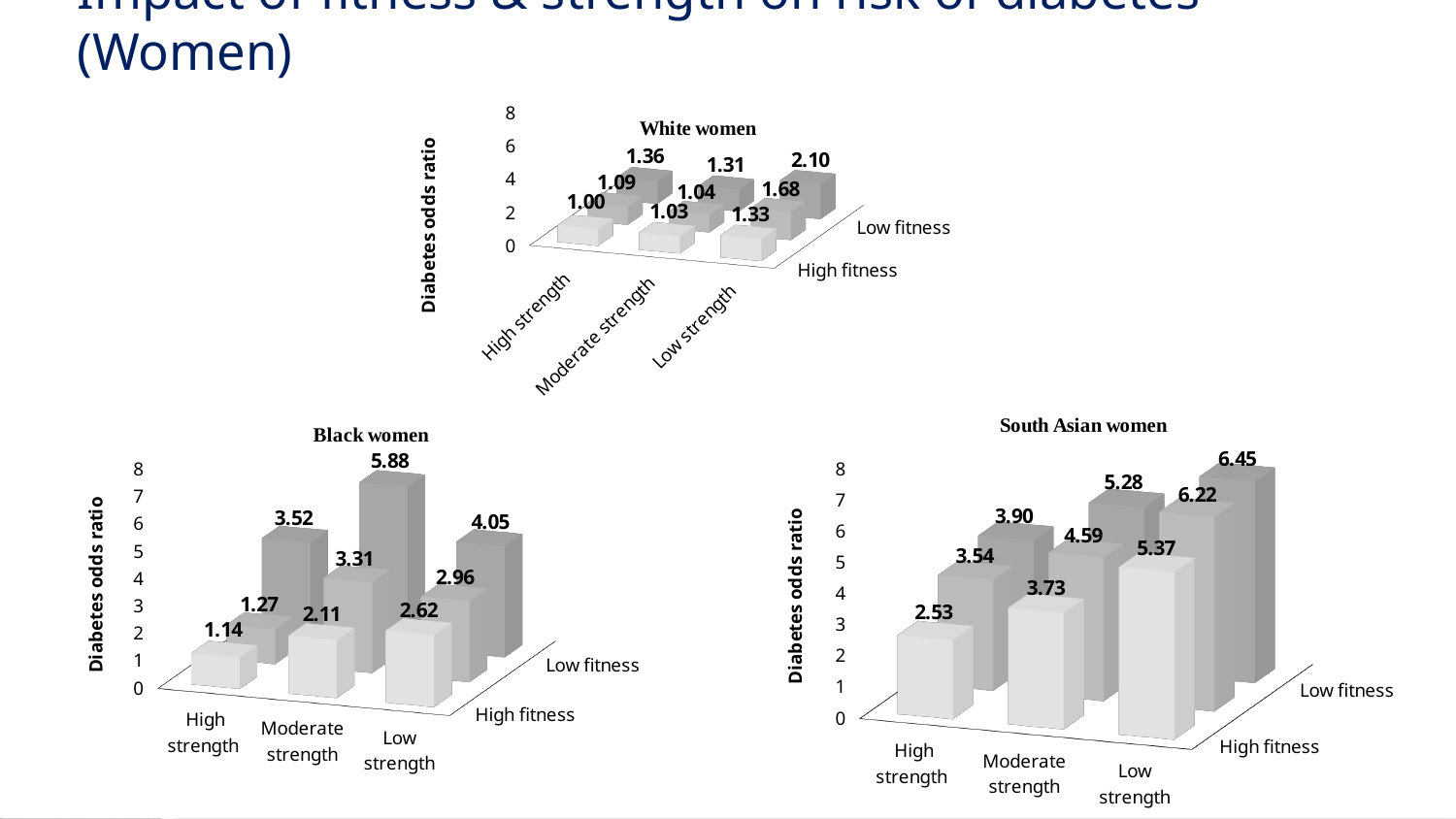
In the Black women chart, do the high fitness odds ratios rise or fall going from high strength to low strength? Rise In the White women chart, what is the diabetes odds ratio for low strength with high fitness? 1.33 In the White women chart, for low fitness, what is the difference between the odds ratio for low strength and for high strength? 0.74 What kind of chart is used for the Black women data? Bar chart How many strength categories are shown along the x axis of the Black women chart? 3 In the Black women chart, for low fitness, what is the difference between the odds ratio for moderate strength and for high strength? 2.36 In the South Asian women chart, what is the diabetes odds ratio for low strength with low fitness? 6.45 In the South Asian women chart, for high fitness, which has the larger odds ratio: low strength or moderate strength? Low strength In the South Asian women chart, what is the lowest diabetes odds ratio shown? 2.53 In the Black women chart, what is the diabetes odds ratio for high strength with high fitness? 1.14 In the South Asian women chart, is the odds ratio for low strength with high fitness greater or less than 4? greater In the Black women chart, what is the highest diabetes odds ratio shown? 5.88